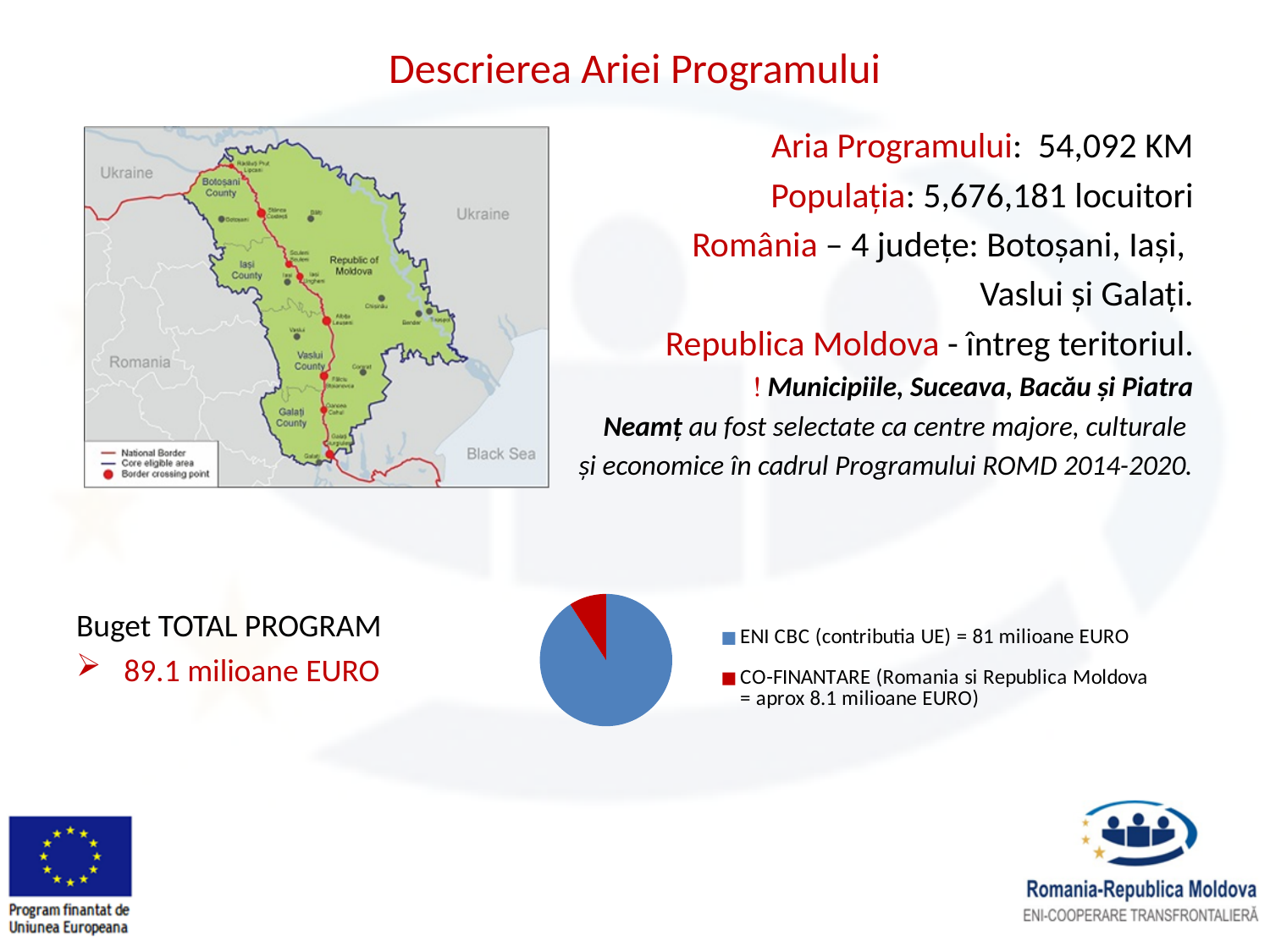
Which slice of the pie chart is the smallest? CO-FINANTARE (Romania si Republica Moldova) What kind of chart is shown at the bottom of the slide? pie chart According to the legend, what is the value of the ENI CBC (contributia UE) slice? 81 milioane EURO How many entries does the legend of the pie chart list? 2 What is the total program budget represented by the pie chart, as stated on the slide? 89.1 milioane EURO What colour is the CO-FINANTARE slice in the pie chart? red Which is larger in the pie chart: ENI CBC (contributia UE) or CO-FINANTARE? ENI CBC (contributia UE) What colour is the ENI CBC (contributia UE) slice in the pie chart? blue Which slice of the pie chart is the largest? ENI CBC (contributia UE) How many slices does the pie chart have? 2 According to the legend, what is the value of the CO-FINANTARE (Romania si Republica Moldova) slice? aprox 8.1 milioane EURO